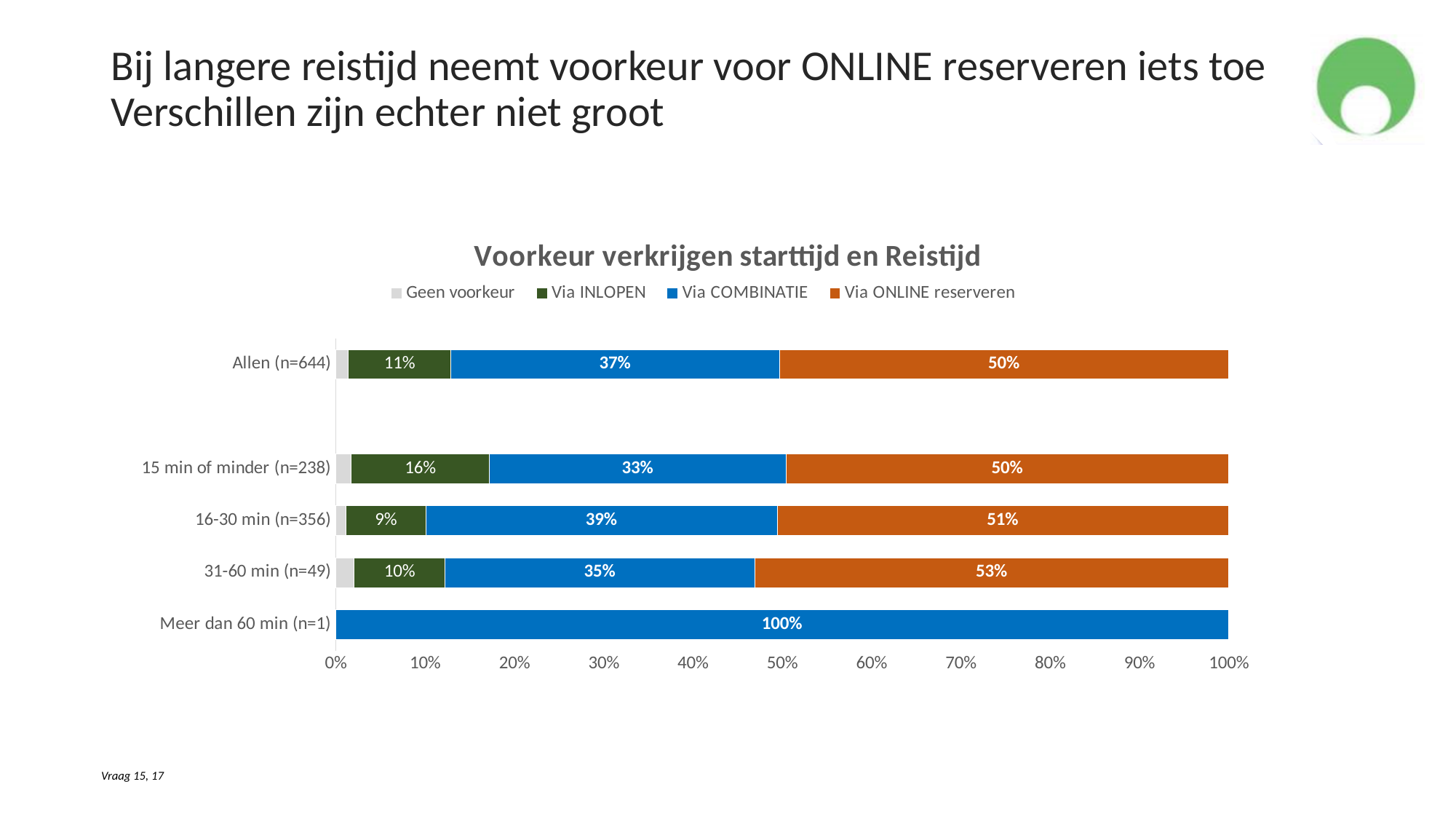
How many series does the legend list? 4 How many categories are shown on the y axis? 5 What is the difference between the Via COMBINATIE values for 16-30 min (n=356) and 15 min of minder (n=238)? 6% What is the title of the chart? Voorkeur verkrijgen starttijd en Reistijd Among the categories with a Via INLOPEN label, which has the lowest Via INLOPEN value? 16-30 min (n=356) Which category has the highest value for Via ONLINE reserveren? 31-60 min (n=49) Which is larger: Via INLOPEN for Allen (n=644) or Via INLOPEN for 15 min of minder (n=238)? 15 min of minder (n=238) What is the value for Via INLOPEN in the 15 min of minder (n=238) category? 16% What is the value for Via COMBINATIE in the Allen (n=644) category? 37% What is the value for Via ONLINE reserveren in the 31-60 min (n=49) category? 53% What kind of chart is this? Stacked bar chart What is the value for Via COMBINATIE in the Meer dan 60 min (n=1) category? 100%